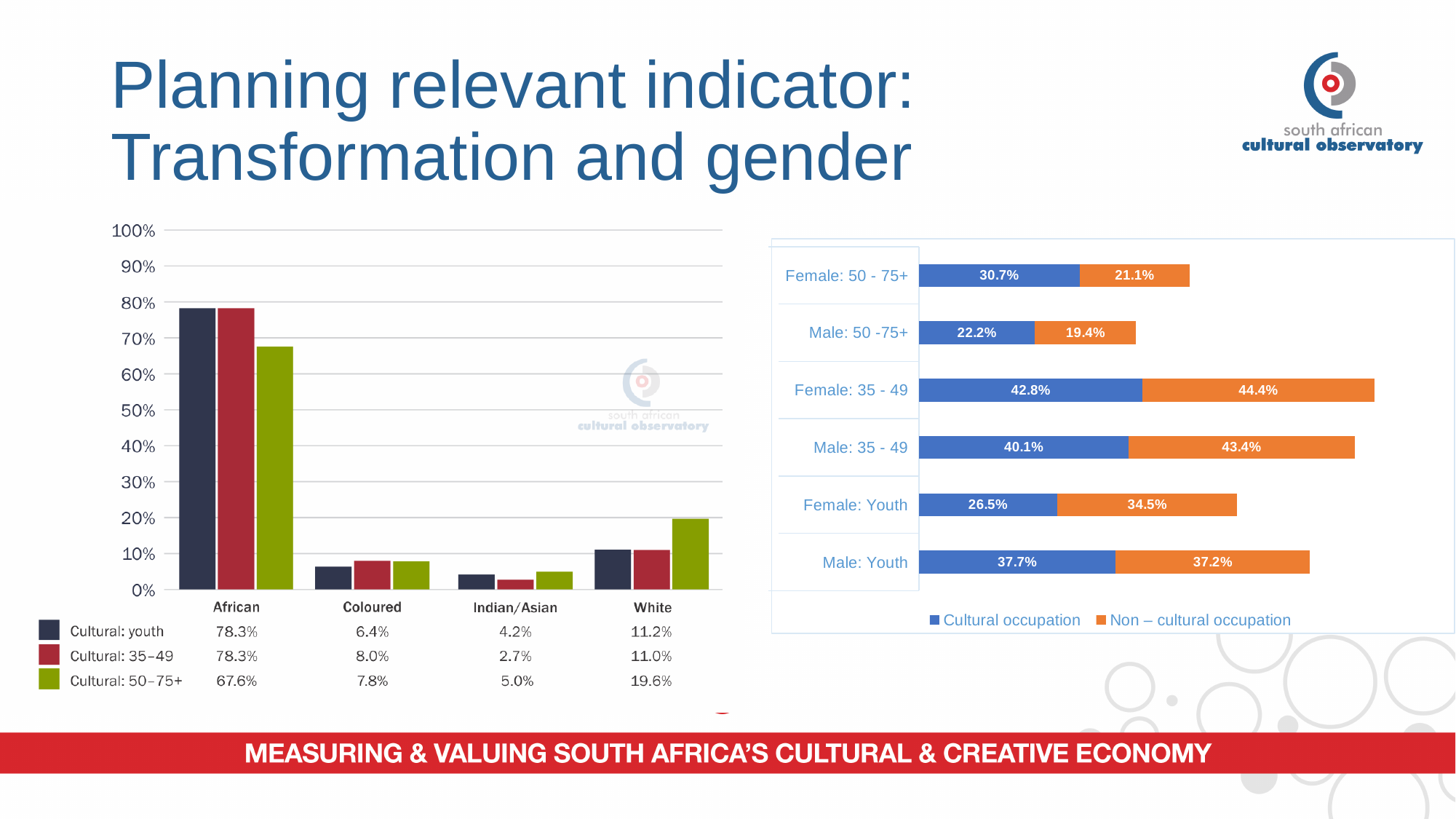
In the right chart, what is the Non – cultural occupation value for Male: 50 -75+? 19.4% In the left chart, how many series does the legend list? 3 In the left chart, what is the value for Cultural: 50–75+ in the White category? 19.6% In the left chart, how many categories are shown on the x axis? 4 In the left chart, which category has the lowest value for Cultural: 35–49? Indian/Asian In the right chart, what is the Cultural occupation value for Female: 35 - 49? 42.8% In the right chart, which group has the lowest Cultural occupation value? Male: 50 -75+ In the left chart, what is the difference between the Cultural: youth and Cultural: 50–75+ values for African? 10.7% In the right chart, what is the total of the stacked bar for Male: Youth? 74.9% In the left chart, what is the value for Cultural: 35–49 in the Indian/Asian category? 2.7% What kind of chart is the right chart? Stacked horizontal bar chart In the left chart, which category has the highest value for Cultural: youth? African